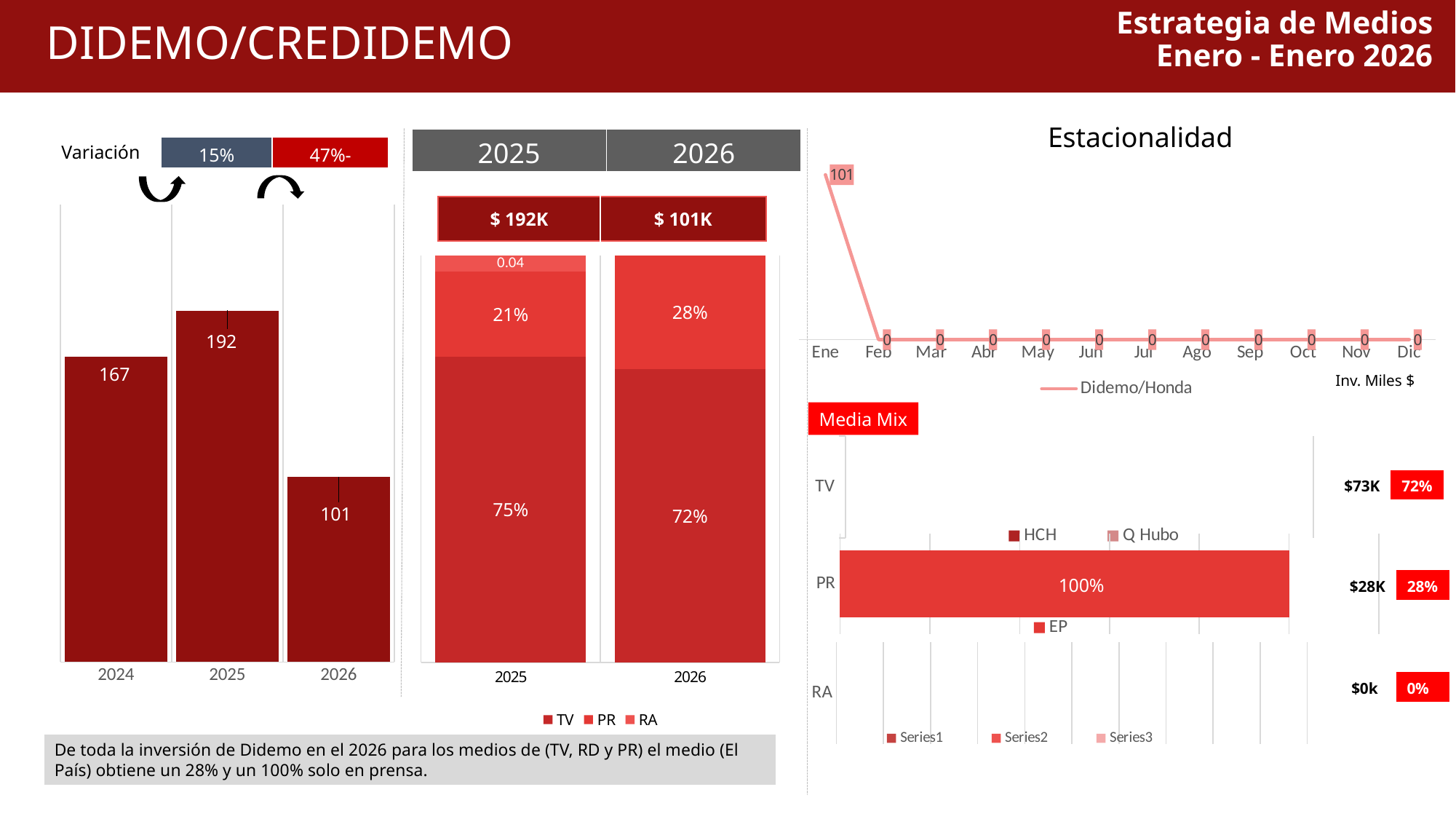
In the Estacionalidad line chart, what is the value for Ene? 101 In the left bar chart, how many years are shown? 3 In the middle stacked bar chart, what share does PR have in 2025? 21% In the left bar chart, which year has the lowest value? 2026 In the left bar chart, which year has the highest value? 2025 In the middle stacked bar chart, how many series does the legend list? 3 In the middle stacked bar chart, what share does TV have in 2026? 72% In the Media Mix chart, what is the amount shown for TV? $73K In the Estacionalidad line chart, what kind of chart is shown? Line chart In the left bar chart, what is the value for 2025? 192 In the left bar chart, what is the difference between the 2025 and 2026 values? 91 In the left bar chart, what is the value for 2024? 167